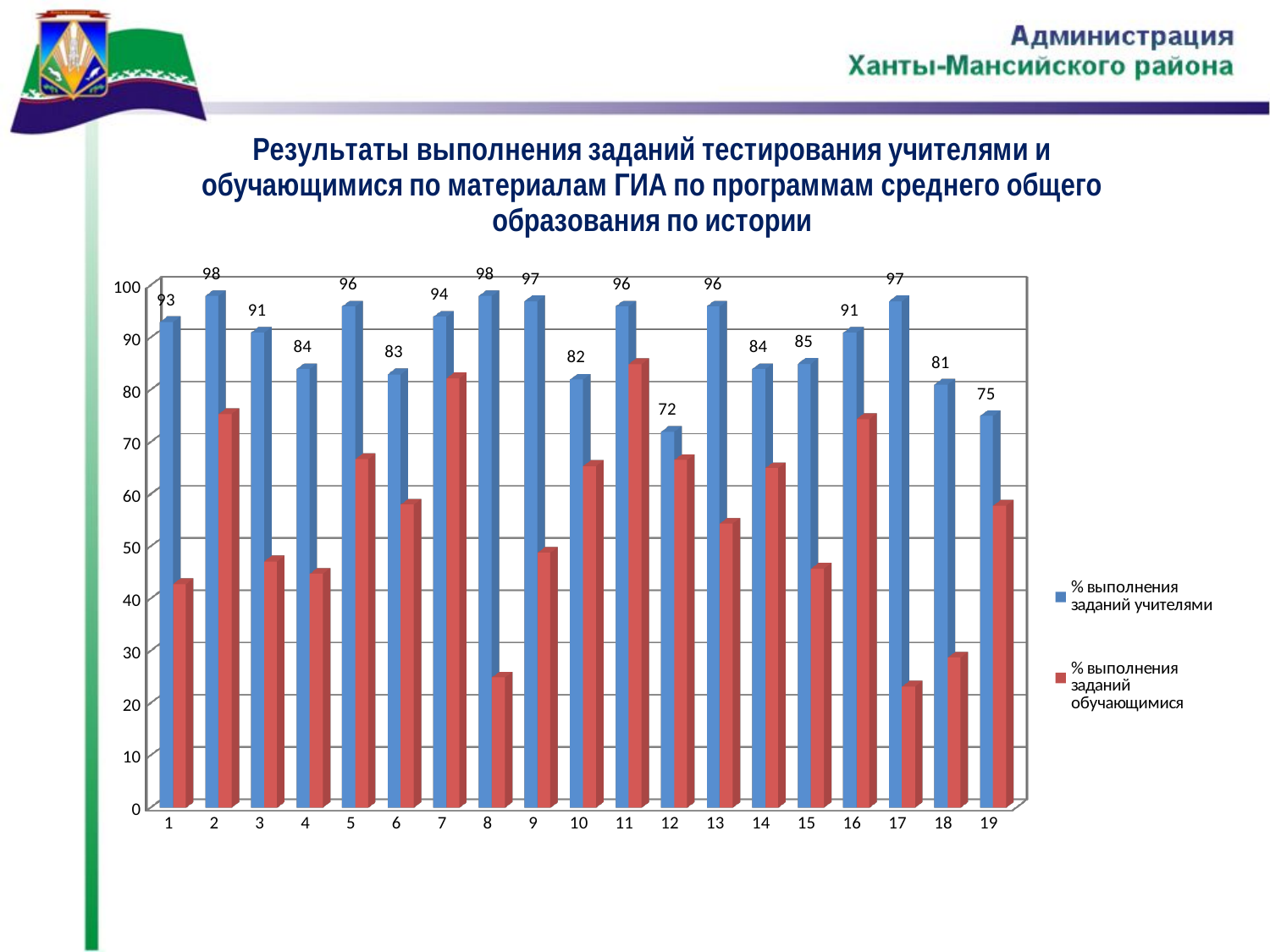
How many series does the legend list? 2 Is the value for category 8 in the '% выполнения заданий обучающимися' series greater or less than 30? less What is the value for category 1 in the '% выполнения заданий учителями' series? 93 What is the difference between the '% выполнения заданий учителями' values for category 2 and category 12? 26 What is the value for category 19 in the '% выполнения заданий учителями' series? 75 Is the value for category 2 in the '% выполнения заданий обучающимися' series greater or less than 70? greater How many categories are shown on the x axis of the chart? 19 Is the value for category 11 in the '% выполнения заданий обучающимися' series greater or less than 80? greater What is the value for category 12 in the '% выполнения заданий учителями' series? 72 Which is larger in the '% выполнения заданий учителями' series: category 9 or category 10? category 9 What kind of chart is shown on the slide? bar chart Which category has the lowest value in the '% выполнения заданий учителями' series? 12